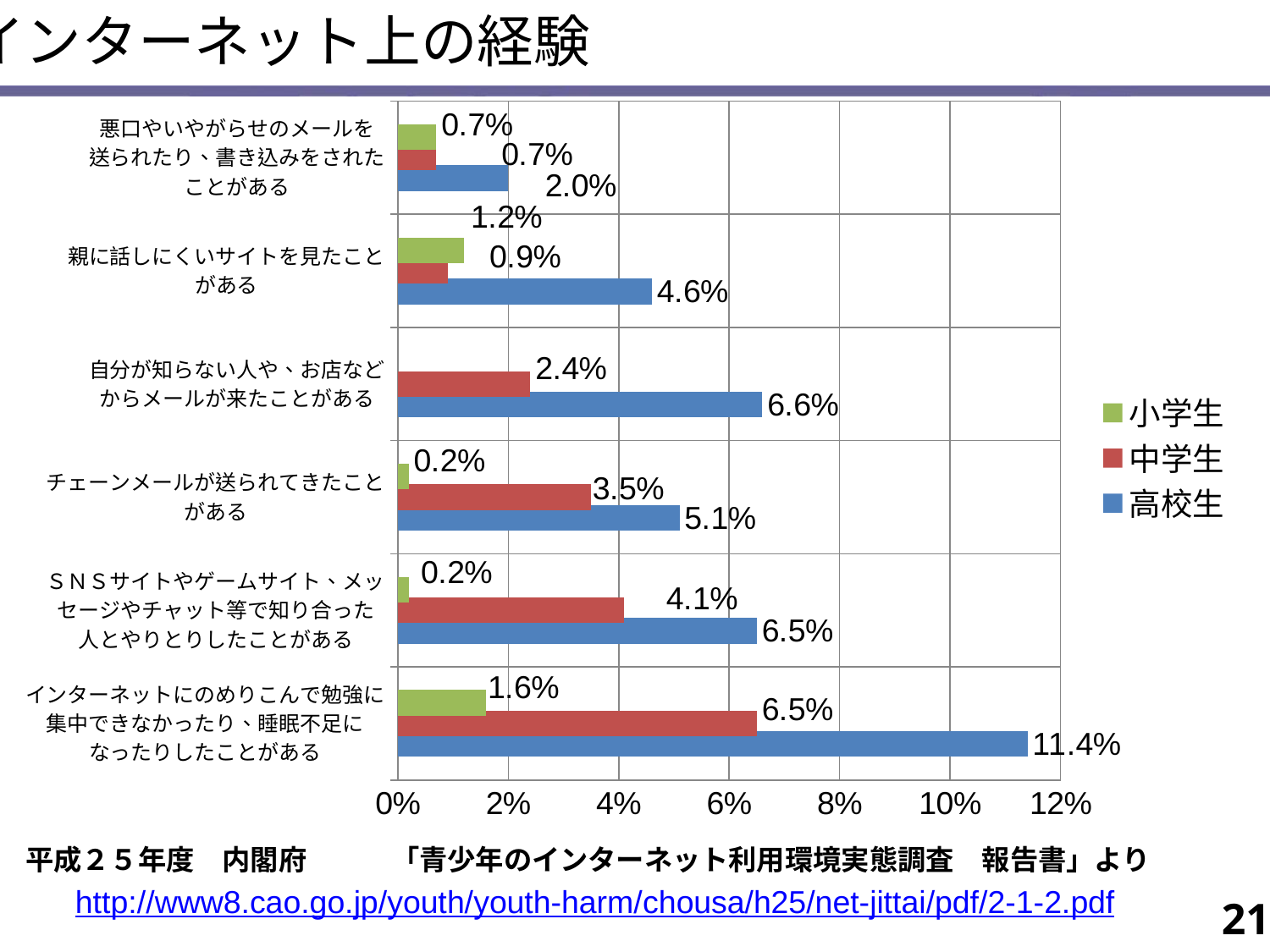
Which category has the highest value for 高校生? インターネットにのめりこんで勉強に集中できなかったり、睡眠不足になったりしたことがある What is the value for 高校生 in the category 「インターネットにのめりこんで勉強に集中できなかったり、睡眠不足になったりしたことがある」? 11.4% What is the difference between the 高校生 and 中学生 values in the category 「自分が知らない人や、お店などからメールが来たことがある」? 4.2% Which category has the lowest value for 高校生? 悪口やいやがらせのメールを送られたり、書き込みをされたことがある What is the value for 小学生 in the category 「親に話しにくいサイトを見たことがある」? 1.2% Which colour represents 中学生 in the chart? Red How many series does the legend list? 3 In the category 「親に話しにくいサイトを見たことがある」, which is larger, the value for 小学生 or for 中学生? 小学生 How many categories are shown on the chart? 6 Is the value for 高校生 in the category 「SNSサイトやゲームサイト、メッセージやチャット等で知り合った人とやりとりしたことがある」 greater or less than 6%? greater What is the value for 中学生 in the category 「チェーンメールが送られてきたことがある」? 3.5% What kind of chart is shown on the slide? Bar chart